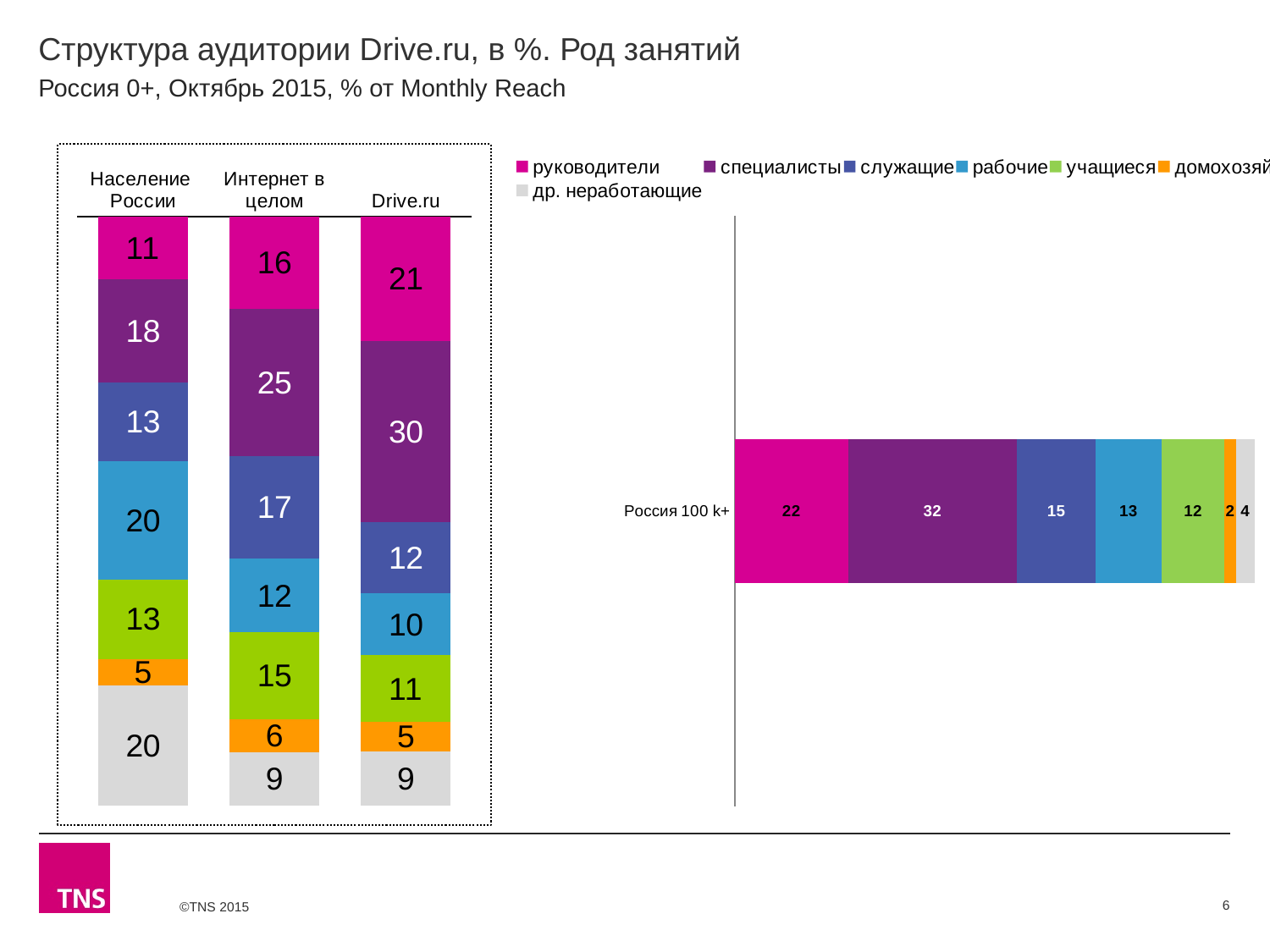
In the left chart, what is the value of the grey bottom segment for Население России? 20 In the left chart, what is the difference between the magenta (руководители) values for Drive.ru and Население России? 10 How many series does the legend on the right list? 7 In the left chart, which of the three columns has the largest purple (специалисты) segment? Drive.ru In the right chart (Россия 100 k+), what is the value of the специалисты segment? 32 In the right chart (Россия 100 k+), what is the value of the учащиеся segment? 12 How many columns (categories) are shown in the left chart? 3 In the left chart, which column has the smallest orange (домохозяйки) segment? Население России and Drive.ru (both 5) In the left chart, is the blue (рабочие) segment larger for Население России or for Drive.ru? Население России What type of chart is the right chart (Россия 100 k+)? Stacked bar chart In the left chart, what is the value of the purple (специалисты) segment for Интернет в целом? 25 In the left chart, what is the value of the top (magenta) segment for Drive.ru? 21